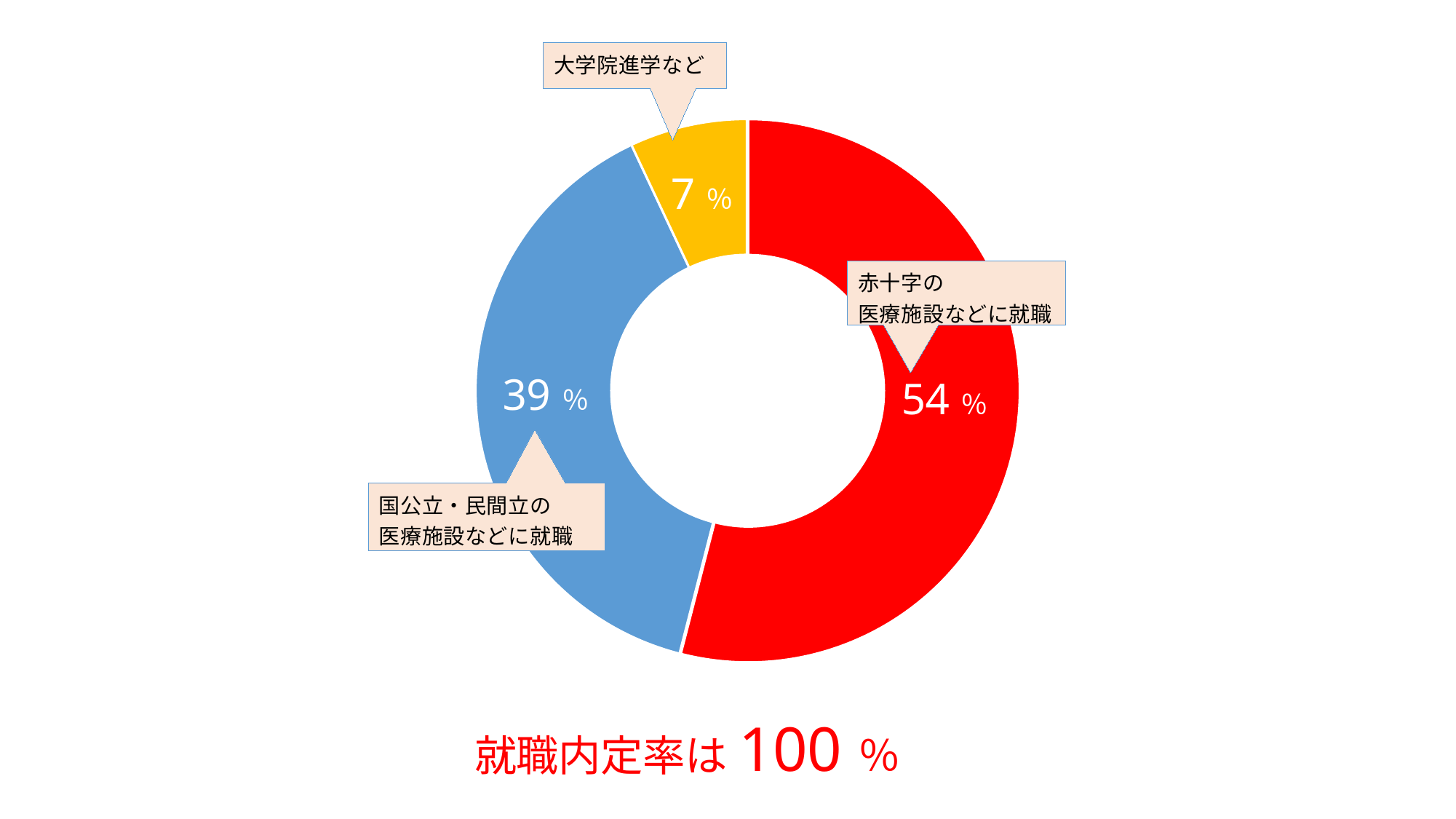
What kind of chart is shown on the slide? Donut (pie) chart Which is larger: the share for 国公立・民間立の医療施設などに就職 or the share for 大学院進学など? 国公立・民間立の医療施設などに就職 What percentage of the donut chart is labelled 国公立・民間立の医療施設などに就職? 39% Which category has the largest share of the donut chart? 赤十字の医療施設などに就職 What colour is the slice for 赤十字の医療施設などに就職? Red How many categories are shown in the donut chart? 3 Which category has the smallest share of the donut chart? 大学院進学など What percentage of the donut chart is labelled 赤十字の医療施設などに就職? 54% What colour is the slice for 大学院進学など? Yellow What is the combined share of the two employment categories (赤十字 and 国公立・民間立)? 93% What is the difference in percentage points between 赤十字の医療施設などに就職 and 国公立・民間立の医療施設などに就職? 15 What percentage of the donut chart is labelled 大学院進学など? 7%